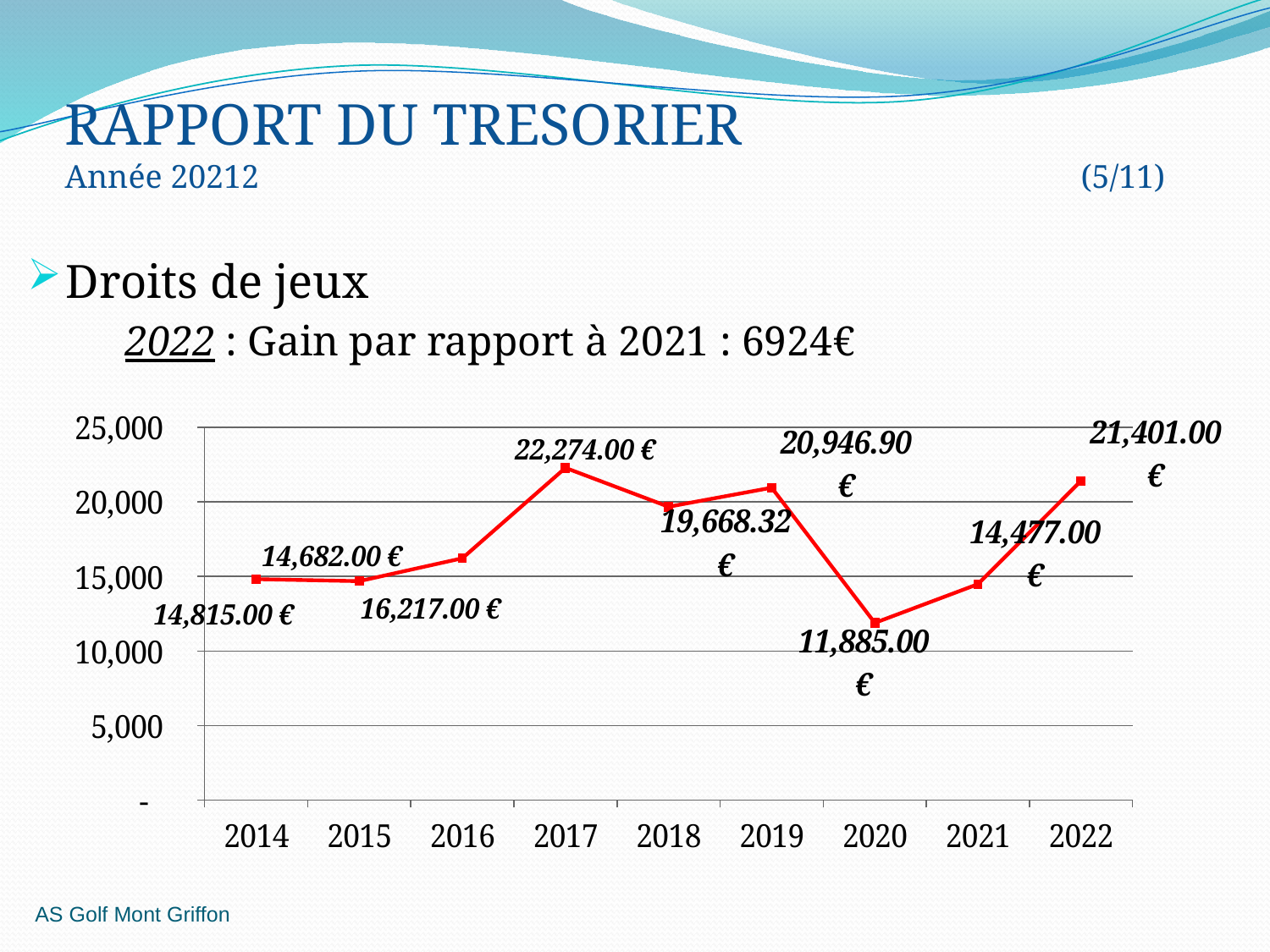
How many years are plotted on the chart? 9 What is the value plotted for 2018? 19,668.32 € What is the value plotted for 2022? 21,401.00 € Which year has the lowest value on the chart? 2020 What is the value plotted for 2020? 11,885.00 € What is the difference between the values for 2017 and 2016? 6,057.00 € What kind of chart is shown on the slide? line chart Is the value for 2020 greater or less than 15,000? less Which year has the highest value on the chart? 2017 What is the difference between the values for 2022 and 2021? 6,924.00 € What is the value plotted for 2017? 22,274.00 € Which year has the larger value, 2018 or 2019? 2019